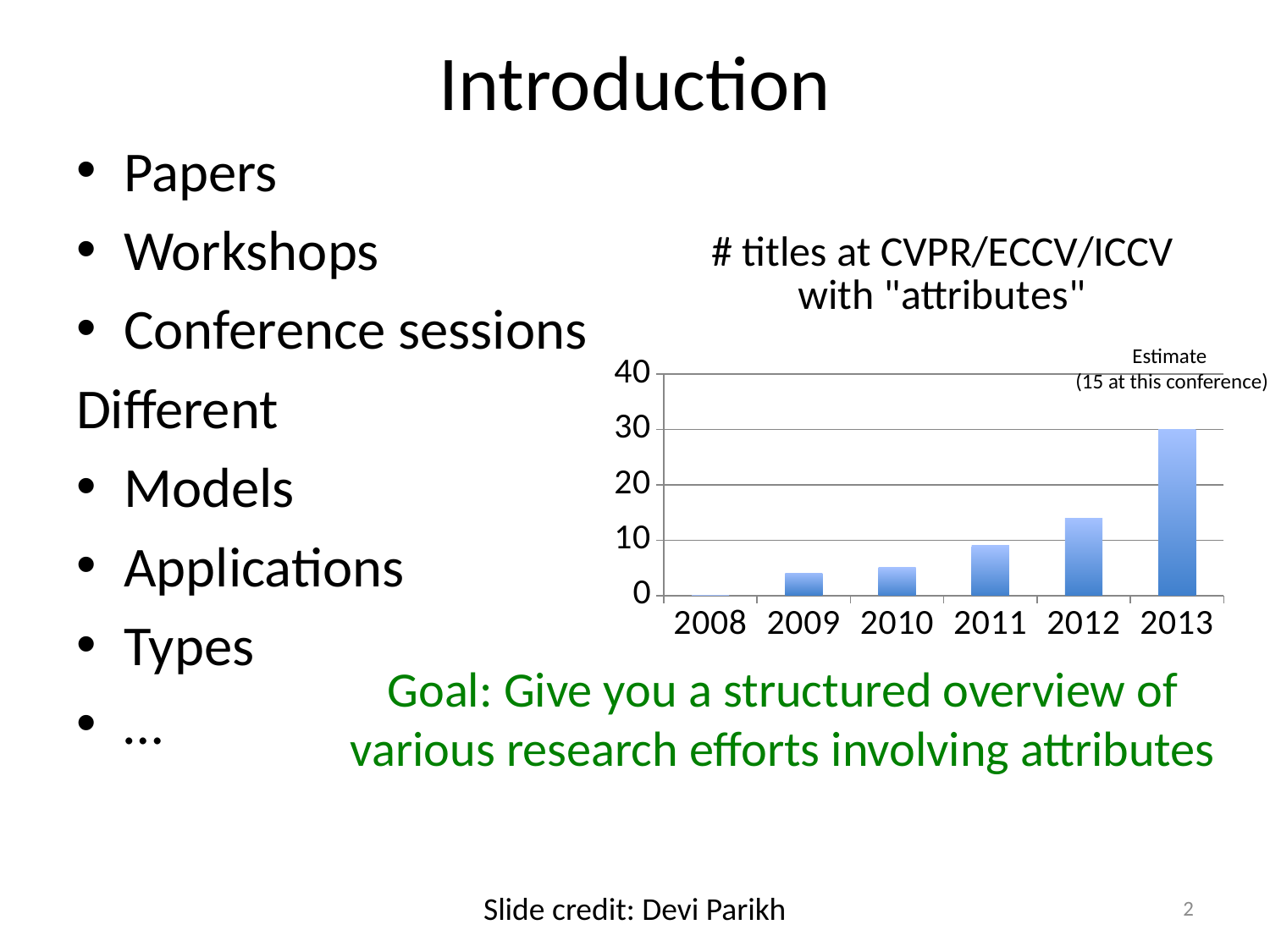
Which year's bar is labelled as an estimate on the chart? 2013 Do the values generally rise or fall from 2008 to 2013? rise Is the value for 2012 greater or less than 10? greater Which year has the highest number of titles with "attributes"? 2013 What is the value for 2013 according to the y axis? 30 Which year has the lowest number of titles with "attributes"? 2008 What is the title of the chart? # titles at CVPR/ECCV/ICCV with "attributes" What kind of chart is shown on the slide? bar chart Which year has the larger value, 2010 or 2012? 2012 How many years are shown on the x axis of the chart? 6 Is the value for 2009 greater or less than 10? less Is the value for 2013 greater or less than 20? greater